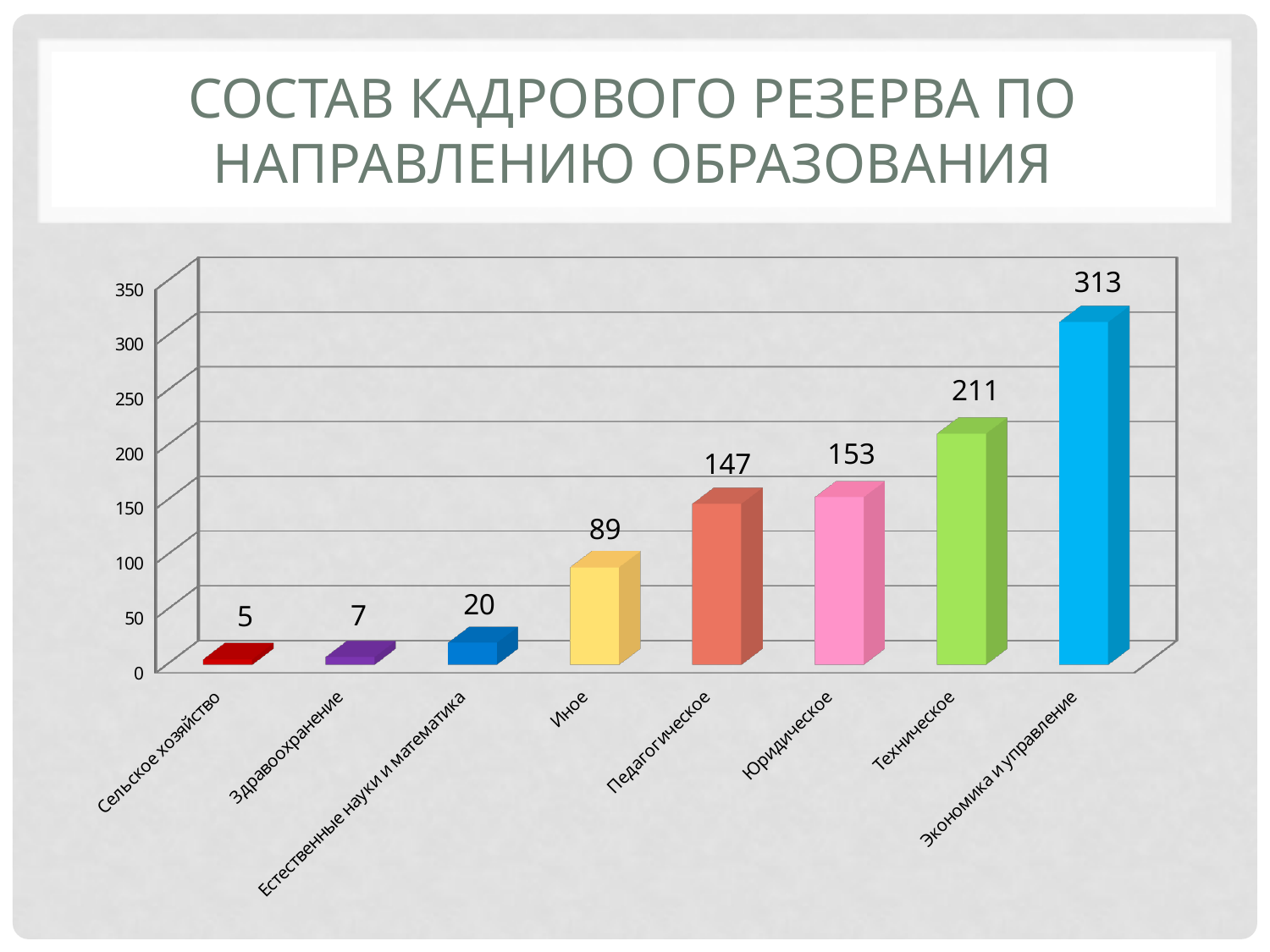
Is the value for Техническое greater or less than 200? greater What is the title of the slide? Состав кадрового резерва по направлению образования Which category has the highest value? Экономика и управление What is the value for Экономика и управление? 313 What is the value for Сельское хозяйство? 5 Do the values rise or fall from left to right along the x axis? rise How many categories are shown on the chart? 8 What is the value for Педагогическое? 147 Which is larger, the value for Иное or the value for Естественные науки и математика? Иное Which category has the lowest value? Сельское хозяйство What kind of chart is shown on the slide? bar chart What is the difference between the values for Техническое and Юридическое? 58